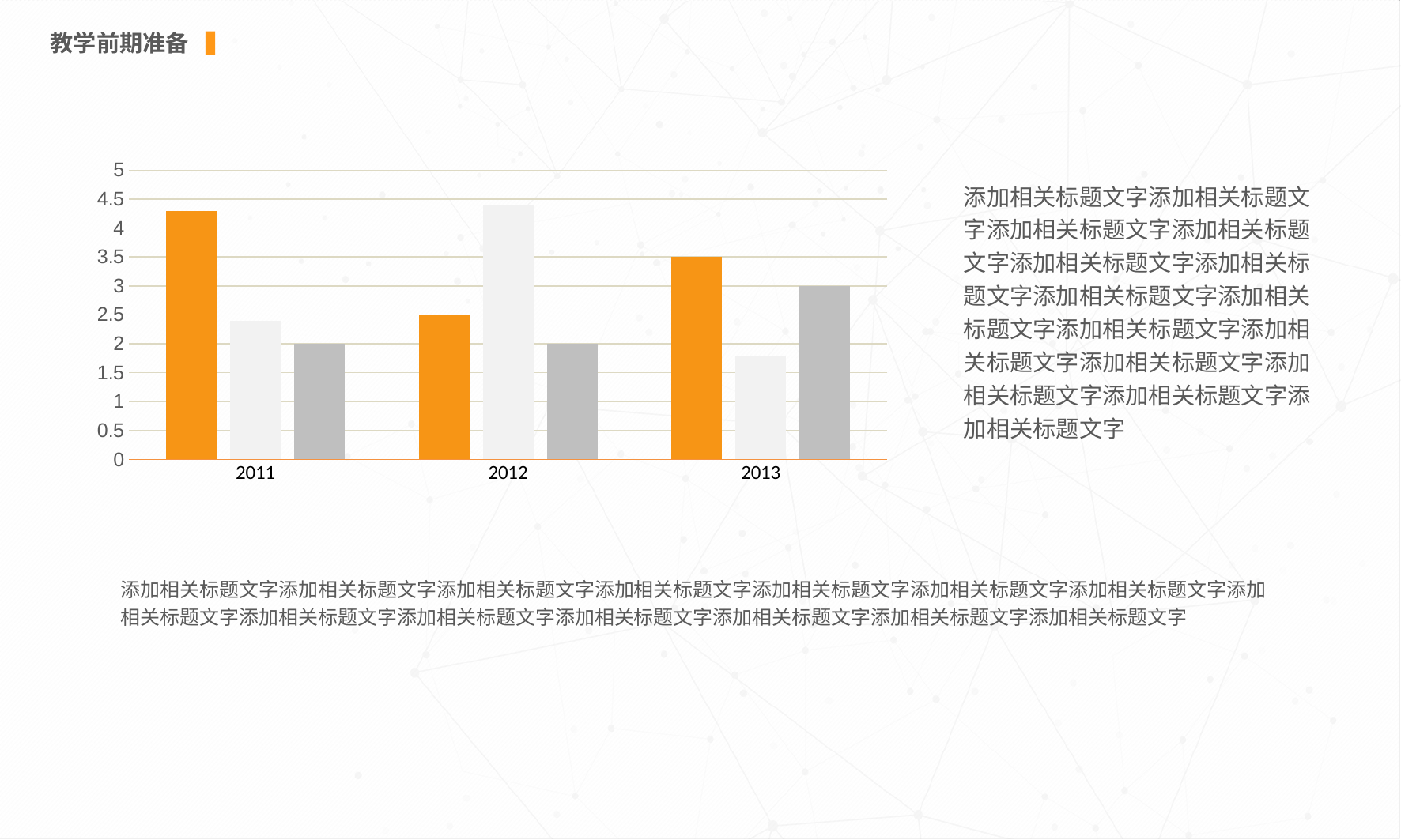
Is the value of the light gray bar for 2012 greater or less than 4? greater Is the value of the orange bar for 2011 greater or less than 4? greater What is the difference between the orange bar for 2013 and the orange bar for 2012? 1 Is the value of the light gray bar for 2013 greater or less than 2? less What kind of chart is shown on the slide? bar chart What is the value of the dark gray bar for 2011? 2 What is the value of the orange bar for 2012? 2.5 What is the value of the dark gray bar for 2013? 3 What is the value of the orange bar for 2013? 3.5 Which year has the highest orange bar? 2011 Which year has the lowest orange bar? 2012 How many categories are shown on the x axis of the chart? 3